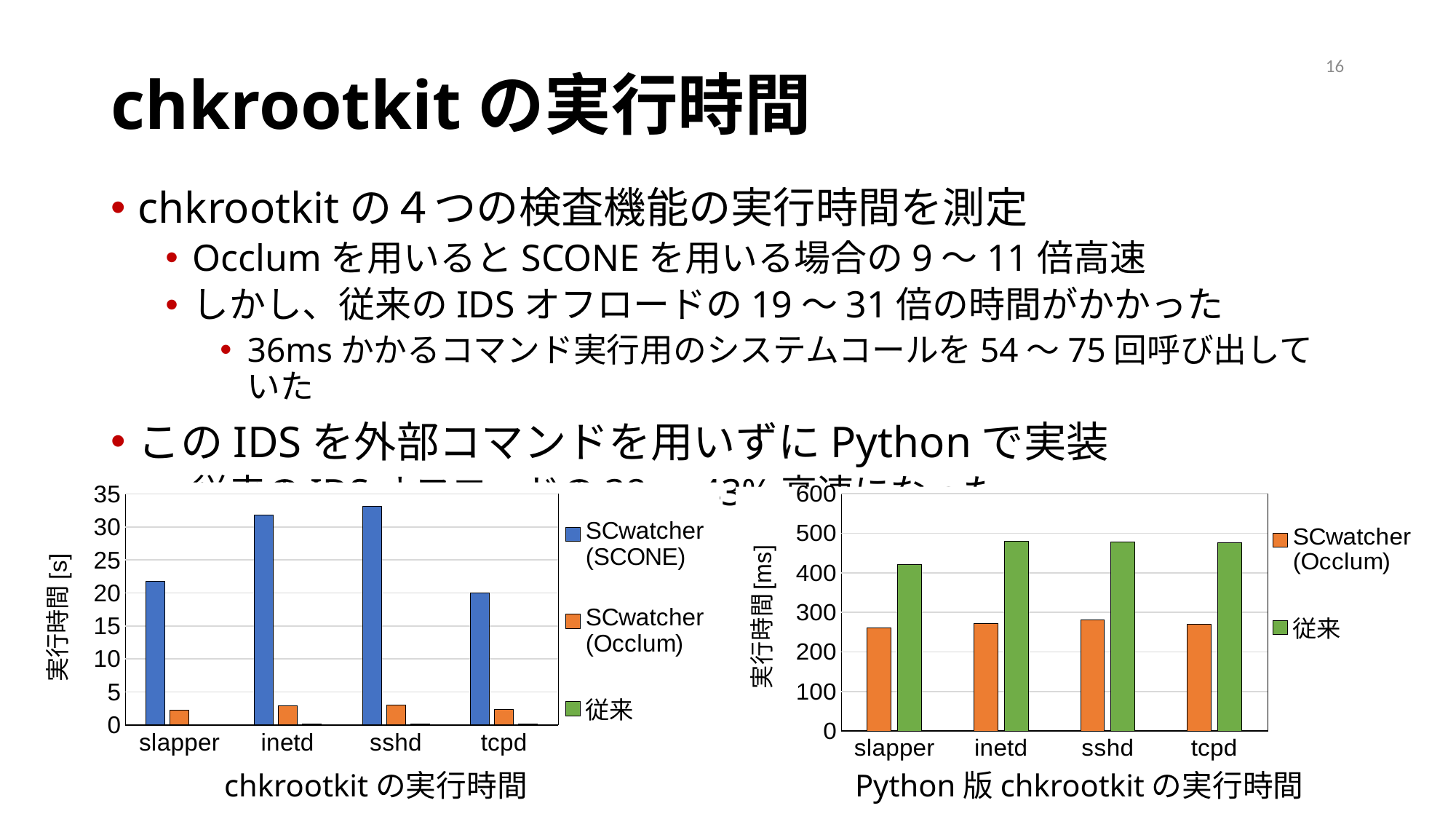
In the left chart 'chkrootkit の実行時間', how many categories are shown on the x axis? 4 In the left chart 'chkrootkit の実行時間', is the SCwatcher (SCONE) value for inetd greater or less than 30? greater In the left chart 'chkrootkit の実行時間', which category has the lowest value for SCwatcher (SCONE)? tcpd In the right chart 'Python 版 chkrootkit の実行時間', how many series does the legend list? 2 In the left chart 'chkrootkit の実行時間', is the SCwatcher (Occlum) value for sshd greater or less than 5? less What is the y-axis label of the right chart 'Python 版 chkrootkit の実行時間'? 実行時間 [ms] In the right chart 'Python 版 chkrootkit の実行時間', which is larger for tcpd: SCwatcher (Occlum) or 従来? 従来 What kind of chart is the left chart titled 'chkrootkit の実行時間'? bar chart In the left chart 'chkrootkit の実行時間', which is larger for slapper: SCwatcher (SCONE) or SCwatcher (Occlum)? SCwatcher (SCONE) In the right chart 'Python 版 chkrootkit の実行時間', which category has the lowest value for 従来? slapper In the right chart 'Python 版 chkrootkit の実行時間', is the 従来 value for inetd greater or less than 400? greater In the left chart 'chkrootkit の実行時間', how many series does the legend list? 3